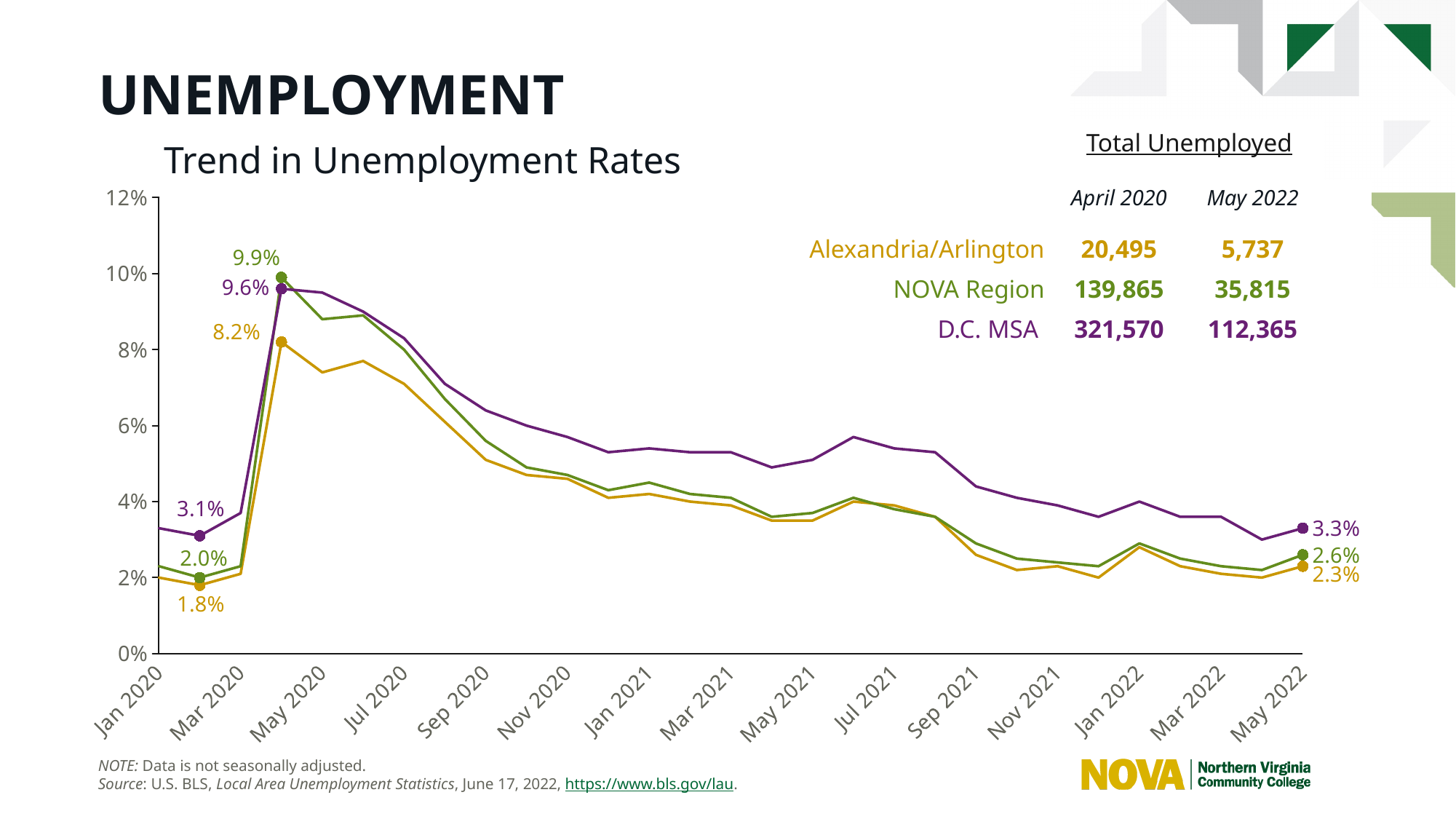
In the Trend in Unemployment Rates chart, what was the D.C. MSA unemployment rate in February 2020? 3.1% What kind of chart is the Trend in Unemployment Rates chart? line chart In the Trend in Unemployment Rates chart, which area had the highest unemployment rate at the April 2020 peak? NOVA Region In the Trend in Unemployment Rates chart, what was the Alexandria/Arlington unemployment rate in February 2020, before the spike? 1.8% In the Trend in Unemployment Rates chart, by how many percentage points did the D.C. MSA rate fall from April 2020 to May 2022? 6.3 percentage points In the Trend in Unemployment Rates chart, what was the NOVA Region unemployment rate at its April 2020 peak? 9.9% In the Trend in Unemployment Rates chart, by how many percentage points did the NOVA Region rate fall from its April 2020 peak of 9.9% to 2.6% in May 2022? 7.3 percentage points In the Trend in Unemployment Rates chart, do the unemployment rates rise or fall from April 2020 to May 2022? fall In the Trend in Unemployment Rates chart, which is higher in May 2022: the D.C. MSA rate or the Alexandria/Arlington rate? D.C. MSA In the Trend in Unemployment Rates chart, is the D.C. MSA unemployment rate in July 2021 greater or less than 4%? greater In the Trend in Unemployment Rates chart, what is the D.C. MSA unemployment rate in May 2022? 3.3% In the Trend in Unemployment Rates chart, which area had the lowest unemployment rate in May 2022? Alexandria/Arlington